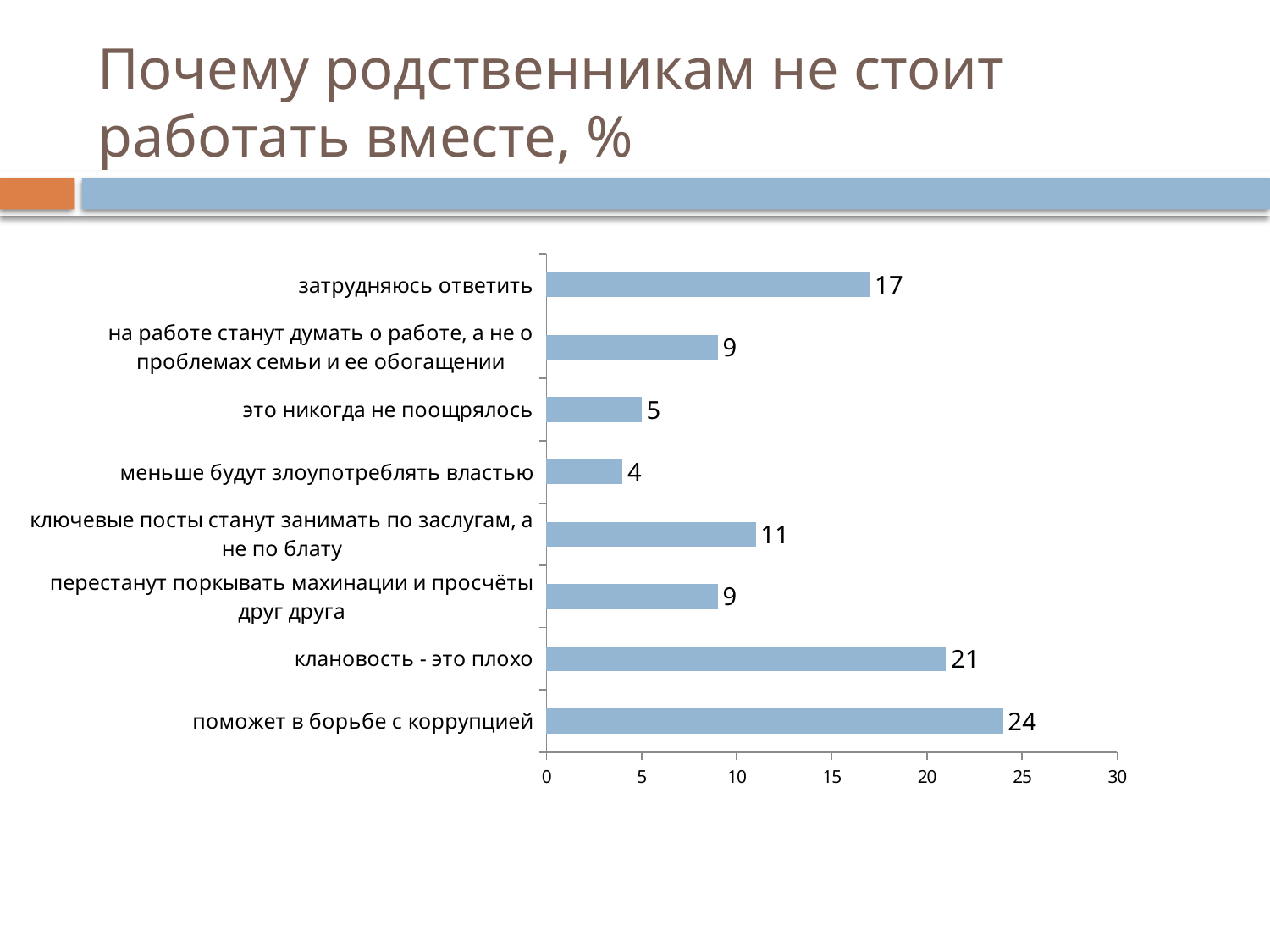
What is the value for "клановость - это плохо"? 21 What is the value for "поможет в борьбе с коррупцией"? 24 Which is larger: the value for "это никогда не поощрялось" or the value for "меньше будут злоупотреблять властью"? это никогда не поощрялось Which category has the highest value? поможет в борьбе с коррупцией What is the difference between the values for "поможет в борьбе с коррупцией" and "клановость - это плохо"? 3 What is the difference between the values for "затрудняюсь ответить" and "ключевые посты станут занимать по заслугам, а не по блату"? 6 What is the value for "ключевые посты станут занимать по заслугам, а не по блату"? 11 What is the title of the slide? Почему родственникам не стоит работать вместе, % What kind of chart is shown on the slide? bar chart How many categories are shown in the chart? 8 Which category has the lowest value? меньше будут злоупотреблять властью What is the value for "затрудняюсь ответить"? 17